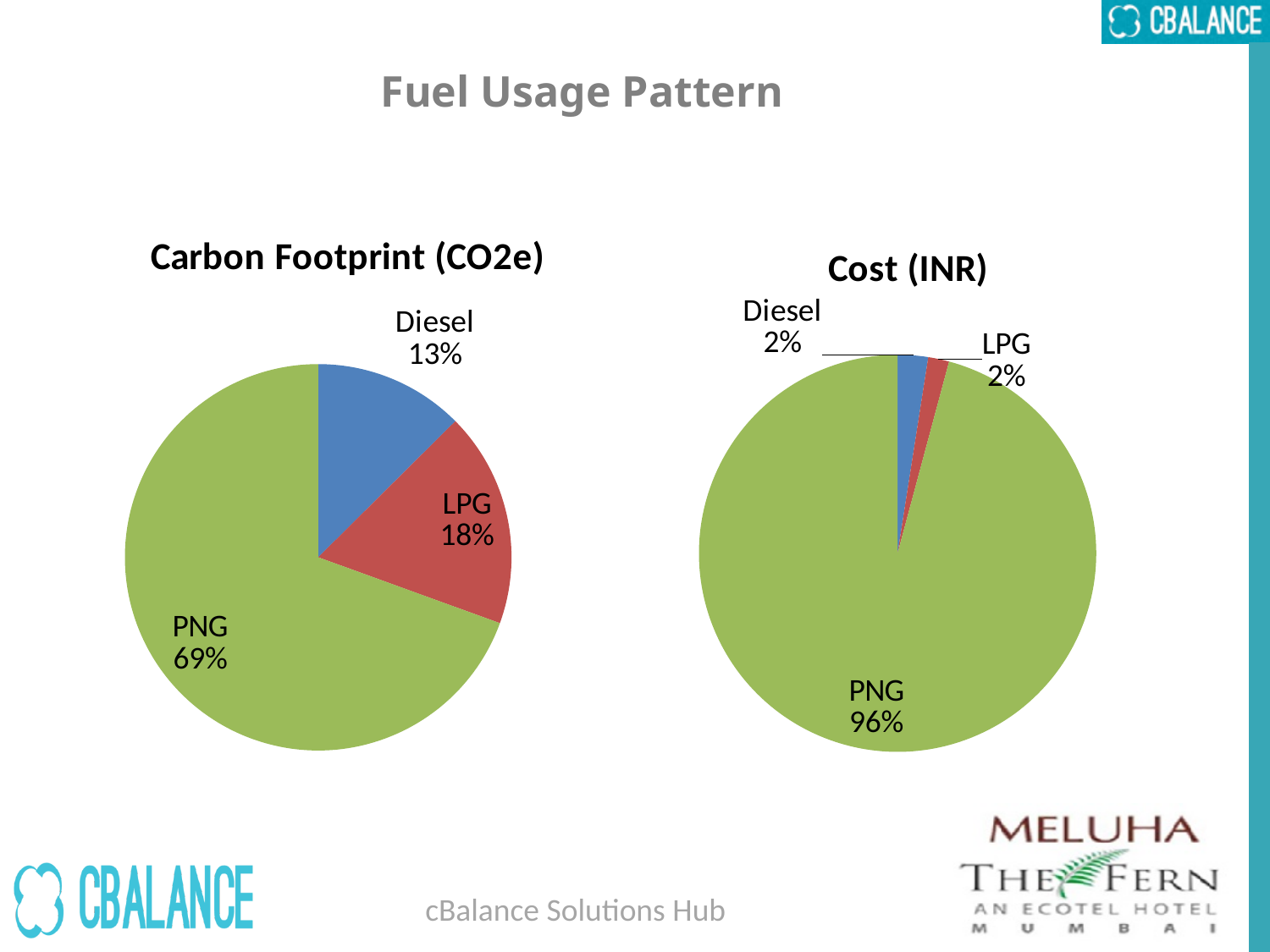
In the Cost (INR) chart, what share does PNG have? 96% In the Carbon Footprint (CO2e) chart, what is the difference between the PNG share and the LPG share? 51% In the Carbon Footprint (CO2e) chart, which fuel has the smallest share? Diesel In the Carbon Footprint (CO2e) chart, what share does LPG have? 18% In the Cost (INR) chart, what share does Diesel have? 2% In the Cost (INR) chart, which fuel has the largest share? PNG In the Carbon Footprint (CO2e) chart, which fuel has the largest share? PNG What kind of chart is the Carbon Footprint (CO2e) chart? Pie chart How many slices does the Cost (INR) chart have? 3 In the Carbon Footprint (CO2e) chart, which has the larger share, LPG or Diesel? LPG